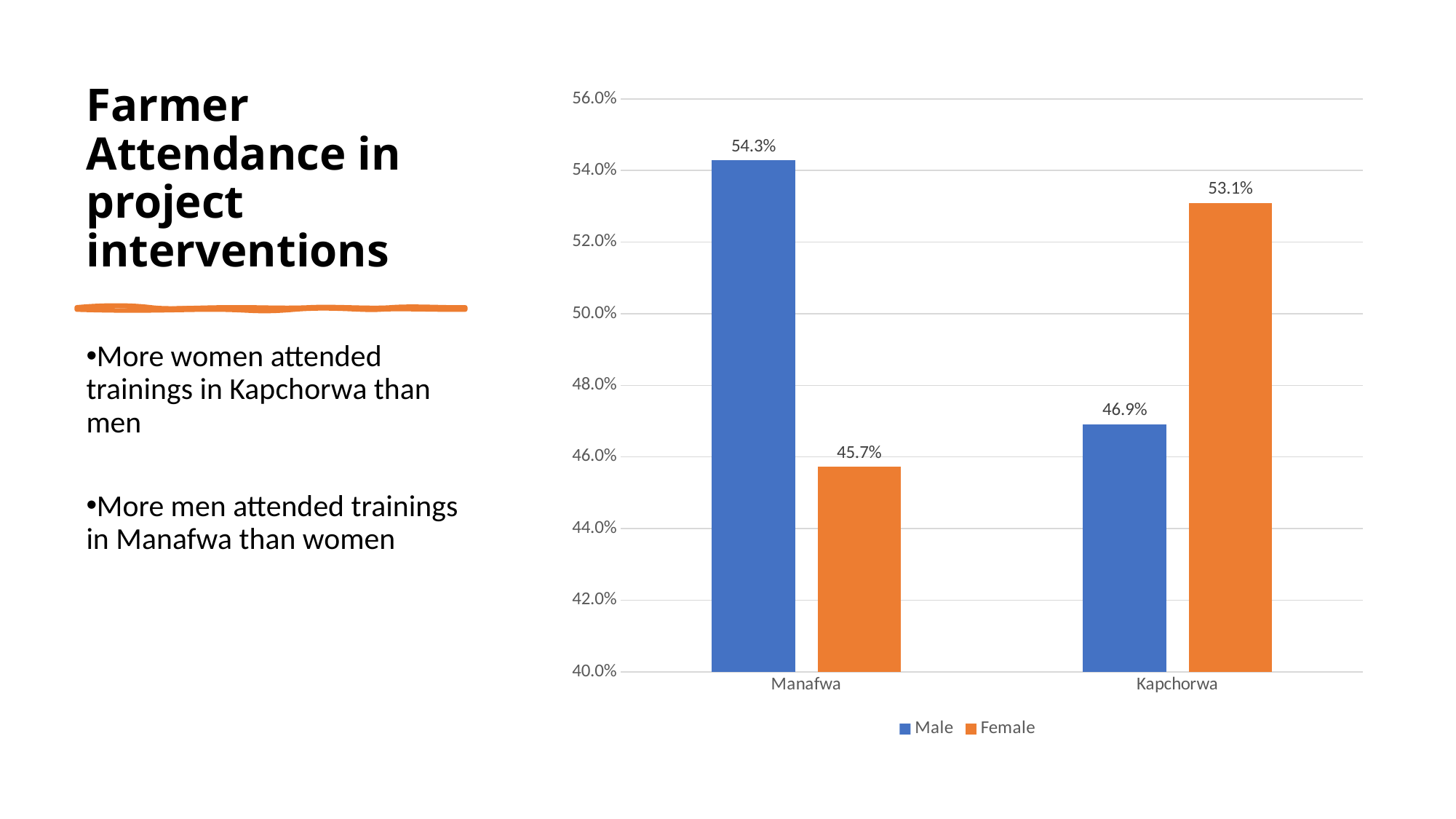
What is the difference between the Male and Female values for Manafwa? 8.6% How many districts are shown on the x axis? 2 What is the Male value for Manafwa? 54.3% What is the Male value for Kapchorwa? 46.9% What is the Female value for Manafwa? 45.7% Which district has the highest Male value? Manafwa In Kapchorwa, which is larger, the Male value or the Female value? Female How many series does the legend list? 2 What is the difference between the Female and Male values for Kapchorwa? 6.2% What kind of chart is shown on the slide? Bar chart What is the Female value for Kapchorwa? 53.1% Which district has the lowest Female value? Manafwa